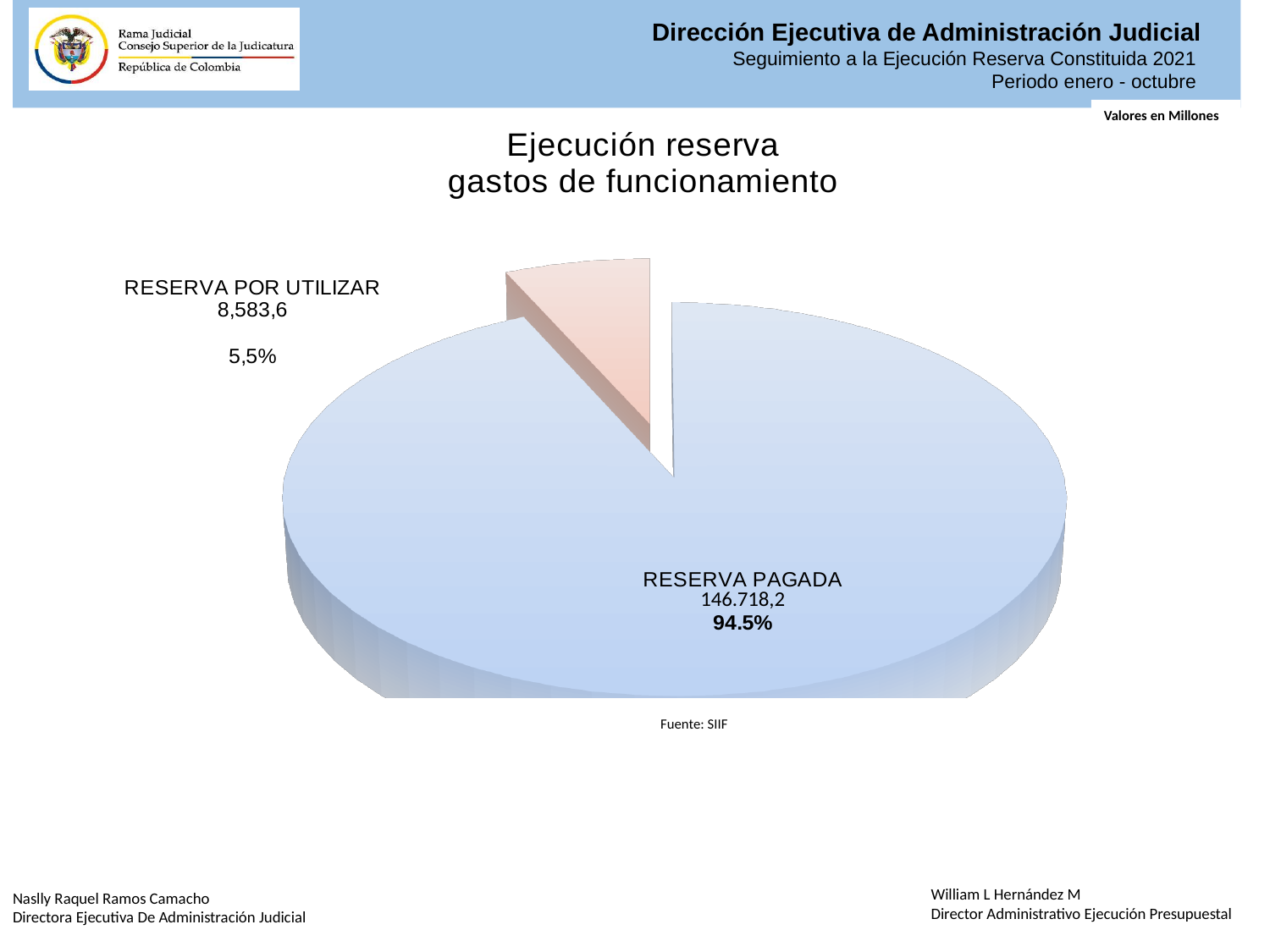
What source is cited below the chart? SIIF What is the value shown for RESERVA PAGADA? 146.718,2 What is the value shown for RESERVA POR UTILIZAR? 8,583,6 What share of the pie does RESERVA PAGADA represent? 94.5% What is the title of the chart? Ejecución reserva gastos de funcionamiento What kind of chart is shown on the slide? Pie chart What share of the pie does RESERVA POR UTILIZAR represent? 5,5% Which slice of the pie is the smallest? RESERVA POR UTILIZAR Which is larger, RESERVA PAGADA or RESERVA POR UTILIZAR? RESERVA PAGADA How many slices does the pie chart have? 2 Which slice of the pie is the largest? RESERVA PAGADA